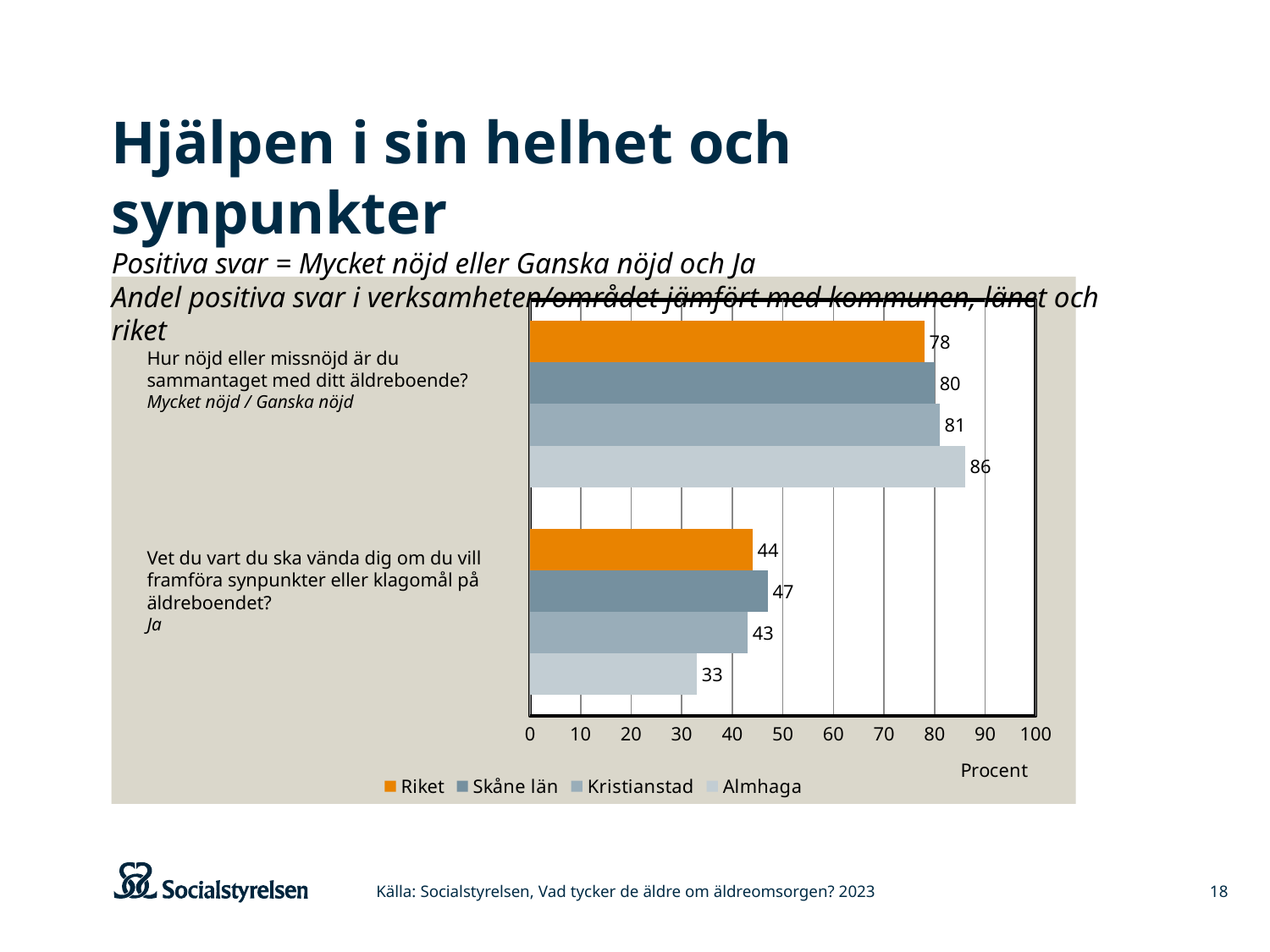
What is the difference between Almhaga and Riket on the question "Hur nöjd eller missnöjd är du sammantaget med ditt äldreboende?"? 8 How many series does the legend list? 4 What is the difference between Skåne län and Almhaga on the question "Vet du vart du ska vända dig om du vill framföra synpunkter eller klagomål på äldreboendet?"? 14 What kind of chart is shown on the slide? Bar chart What is the value for Skåne län on the question "Hur nöjd eller missnöjd är du sammantaget med ditt äldreboende?"? 80 On the question "Vet du vart du ska vända dig om du vill framföra synpunkter eller klagomål på äldreboendet?", which is larger: Skåne län or Kristianstad? Skåne län Which series has the highest value on the question "Hur nöjd eller missnöjd är du sammantaget med ditt äldreboende?"? Almhaga Which series has the lowest value on the question "Vet du vart du ska vända dig om du vill framföra synpunkter eller klagomål på äldreboendet?"? Almhaga Is the value for Kristianstad on the question "Hur nöjd eller missnöjd är du sammantaget med ditt äldreboende?" greater or less than 70? greater What is the value for Riket on the question "Vet du vart du ska vända dig om du vill framföra synpunkter eller klagomål på äldreboendet?"? 44 What is the label of the x axis of the chart? Procent What is the value for Almhaga on the question "Hur nöjd eller missnöjd är du sammantaget med ditt äldreboende?"? 86